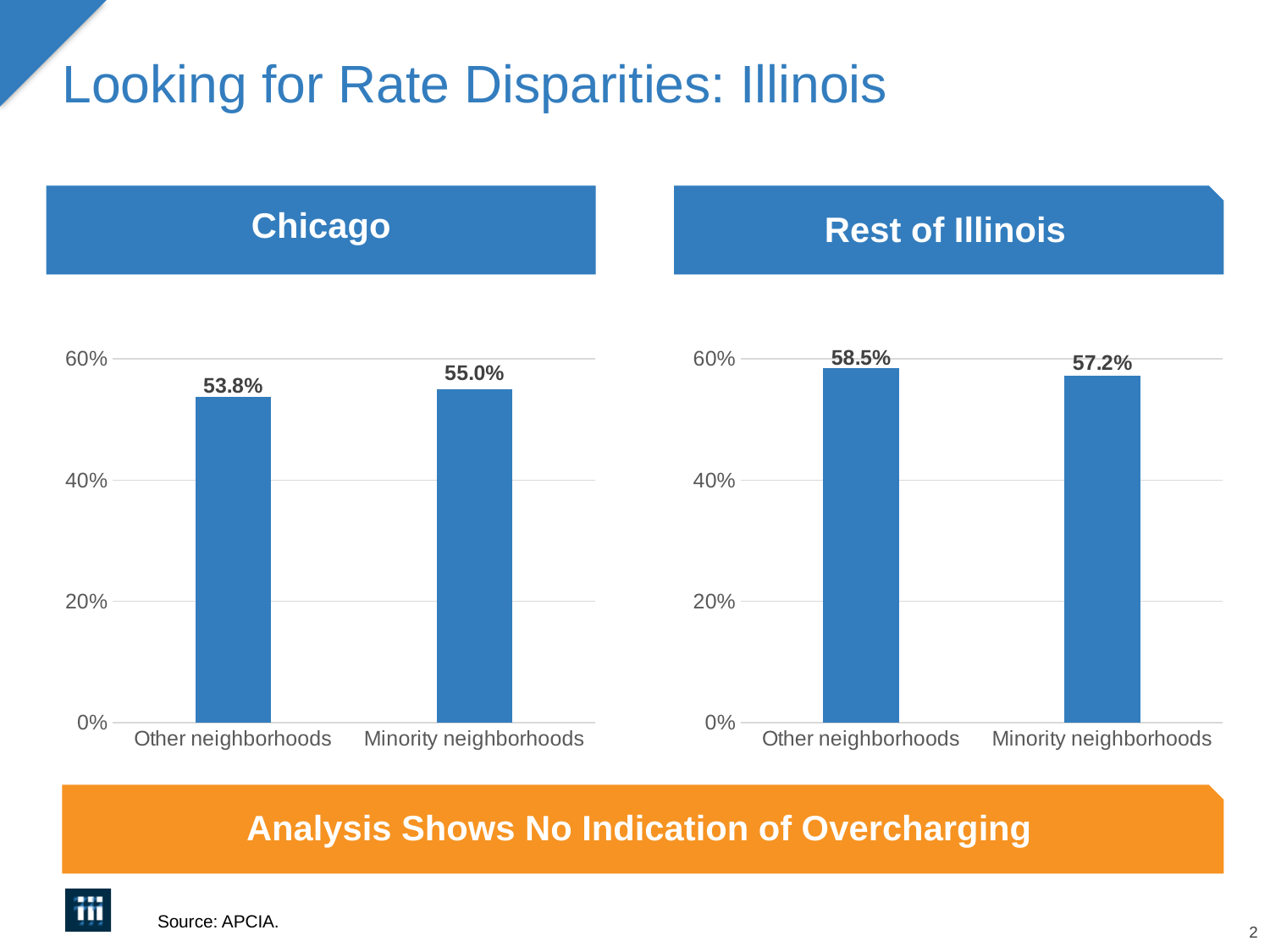
What kind of chart is the Chicago chart? Bar chart In the Rest of Illinois chart, what is the value for Other neighborhoods? 58.5% In the Rest of Illinois chart, what is the difference between Other neighborhoods and Minority neighborhoods? 1.3% Is the value for Other neighborhoods in the Rest of Illinois chart larger than the value for Other neighborhoods in the Chicago chart? Yes In the Chicago chart, is the value for Other neighborhoods greater or less than 40%? greater In the Chicago chart, what is the value for Other neighborhoods? 53.8% How many categories are shown in the Rest of Illinois chart? 2 In the Chicago chart, what is the value for Minority neighborhoods? 55.0% In the Chicago chart, which category has the higher value? Minority neighborhoods In the Rest of Illinois chart, which category has the lower value? Minority neighborhoods In the Rest of Illinois chart, what is the value for Minority neighborhoods? 57.2% In the Chicago chart, what is the difference between Minority neighborhoods and Other neighborhoods? 1.2%